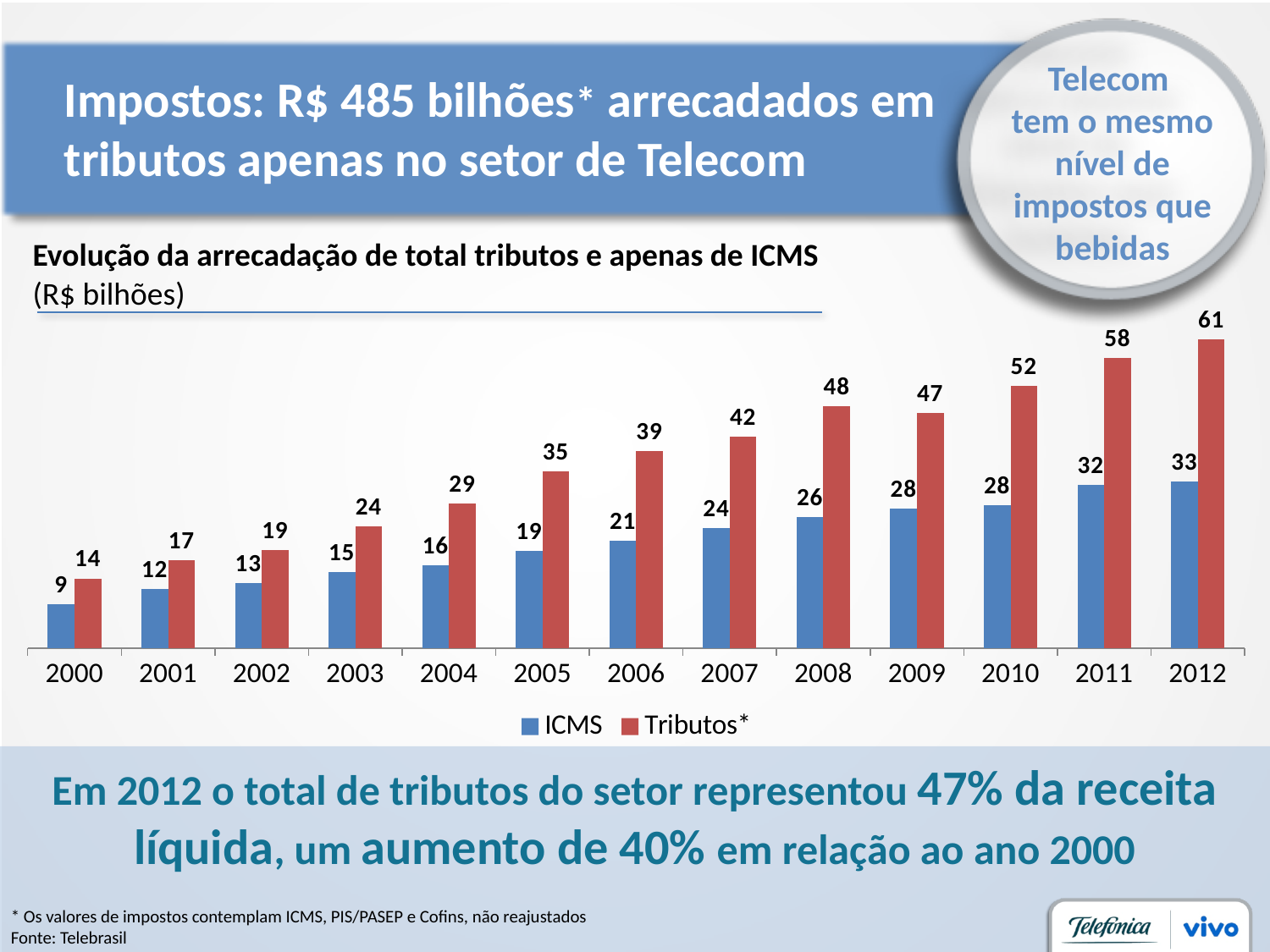
Which is larger, the Tributos* value for 2009 or the Tributos* value for 2010? 2010 What is the Tributos* value for 2008? 48 What is the difference between the Tributos* value and the ICMS value in 2012? 28 Do the Tributos* values generally rise or fall from 2000 to 2012? rise What is the ICMS value for 2012? 33 What colour are the ICMS bars? blue What kind of chart is shown on the slide? bar chart Which year has the highest Tributos* value? 2012 How many series does the legend list? 2 Which year has the lowest ICMS value? 2000 How many years are shown on the x axis? 13 What is the ICMS value for 2005? 19